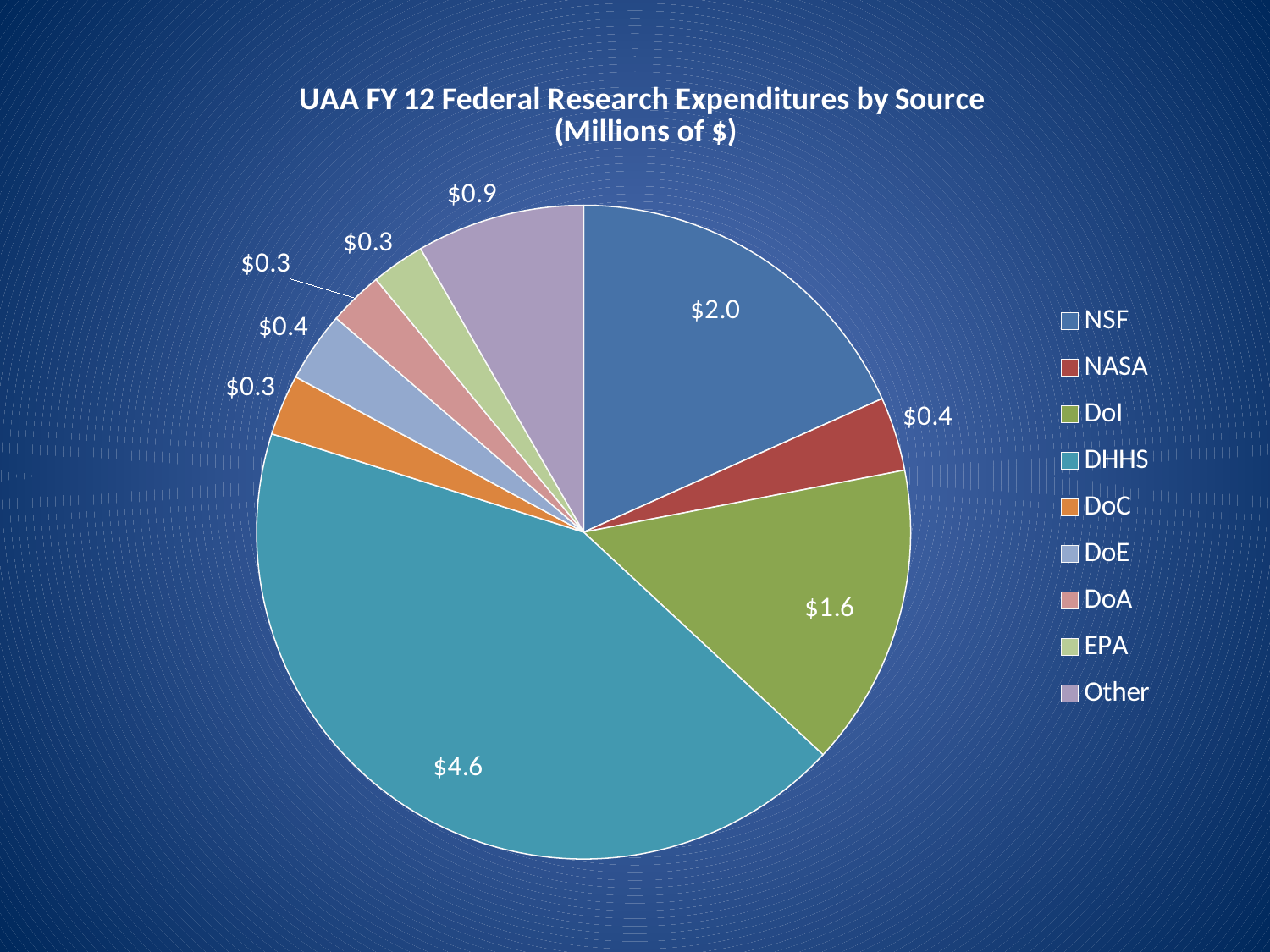
What is the value for Other? $0.9 What is the value for NSF? $2.0 What kind of chart is shown on the slide? Pie chart What is the value for DHHS? $4.6 Which source has the largest slice of the pie? DHHS What is the difference between the DHHS value and the NSF value? $2.6 What is the title of the chart? UAA FY 12 Federal Research Expenditures by Source (Millions of $) How many sources are shown in the pie chart? 9 What is the value for DoI? $1.6 Which is larger, the value for NSF or the value for DoI? NSF What is the total of all the slices in the pie chart? $10.8 What is the difference between the NSF value and the DoI value? $0.4